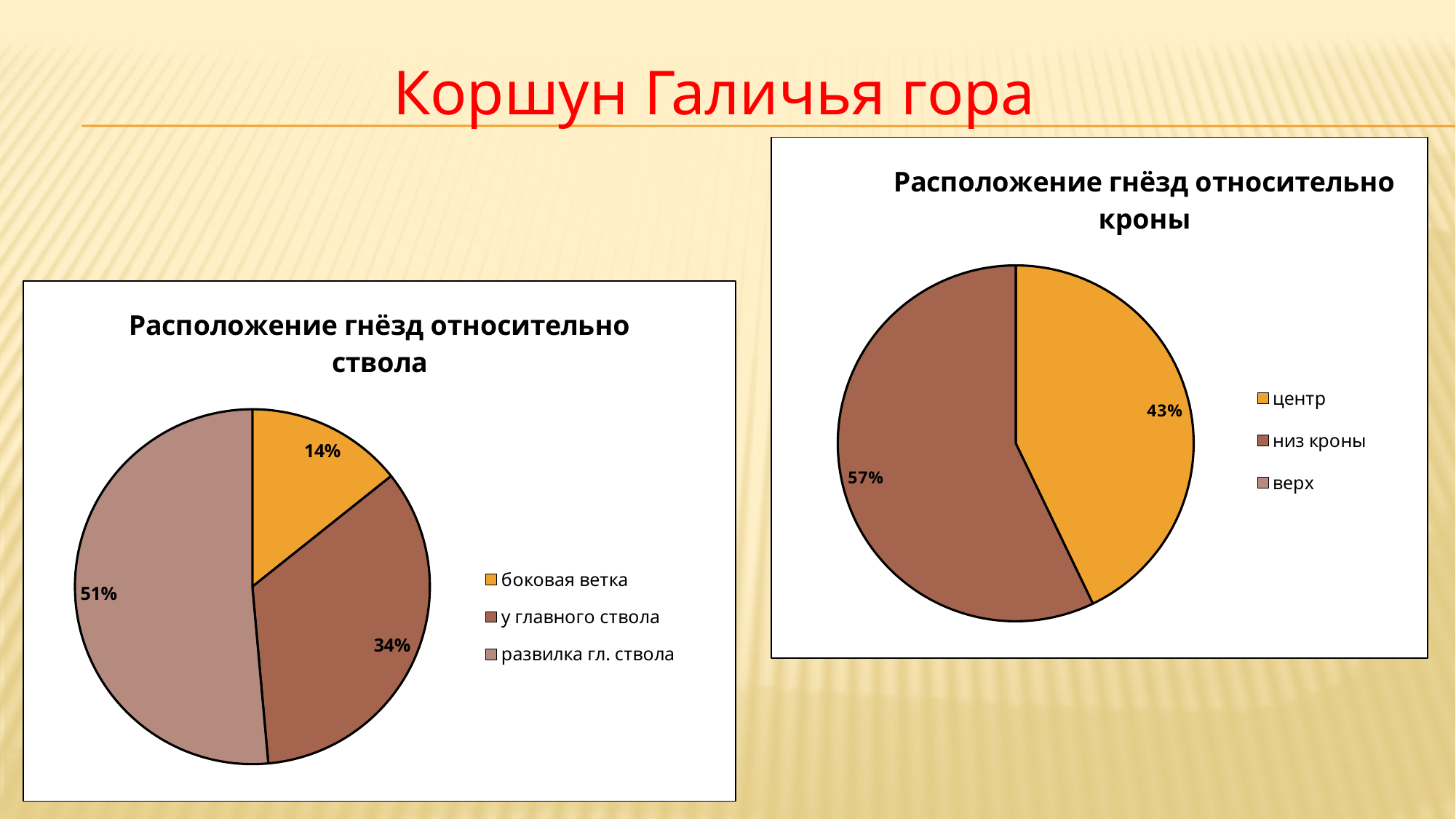
In the chart "Расположение гнёзд относительно кроны", what share is labelled for "низ кроны"? 57% In the chart "Расположение гнёзд относительно ствола", what share is labelled for "у главного ствола"? 34% In the chart "Расположение гнёзд относительно ствола", what is the difference in percentage points between "развилка гл. ствола" and "у главного ствола"? 17 In the chart "Расположение гнёзд относительно ствола", what share is labelled for "развилка гл. ствола"? 51% In the chart "Расположение гнёзд относительно кроны", which is larger, "центр" or "низ кроны"? низ кроны In the chart "Расположение гнёзд относительно ствола", which category has the smallest slice? боковая ветка How many entries does the legend of the chart "Расположение гнёзд относительно ствола" list? 3 In the chart "Расположение гнёзд относительно ствола", which category has the largest slice? развилка гл. ствола What kind of chart is the chart titled "Расположение гнёзд относительно ствола"? pie chart In the chart "Расположение гнёзд относительно кроны", what colour is the slice for "центр"? orange